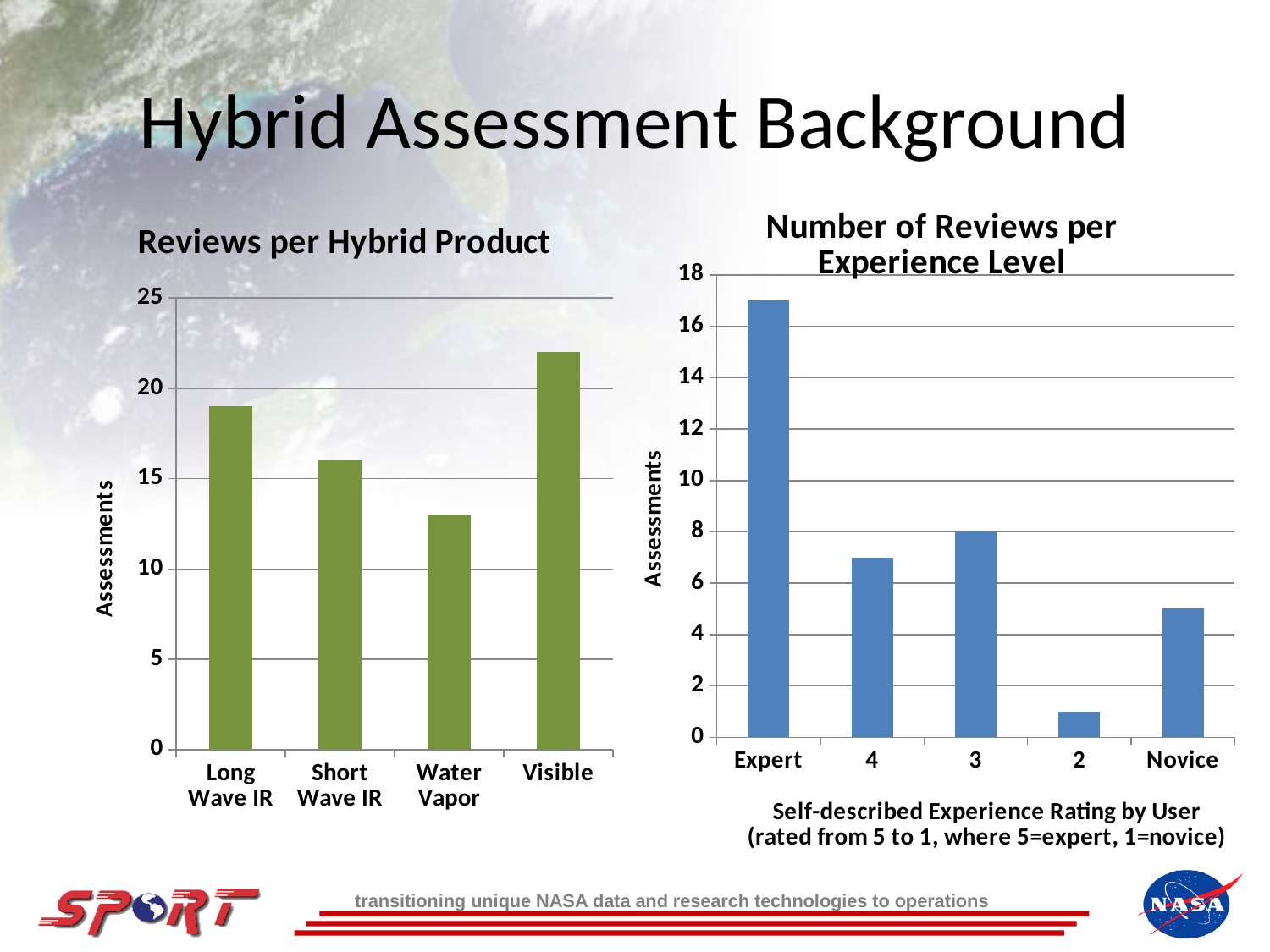
How many product categories are shown on the 'Reviews per Hybrid Product' chart? 4 On the 'Reviews per Hybrid Product' chart, is the value for Water Vapor greater or less than 15? less On the 'Reviews per Hybrid Product' chart, which has more assessments, Long Wave IR or Short Wave IR? Long Wave IR What type of chart is the 'Reviews per Hybrid Product' chart? bar chart On the 'Reviews per Hybrid Product' chart, which product has the lowest number of assessments? Water Vapor On the 'Number of Reviews per Experience Level' chart, is the value for Expert greater or less than 16? greater On the 'Number of Reviews per Experience Level' chart, which experience level has the lowest number of assessments? 2 On the 'Reviews per Hybrid Product' chart, is the value for Visible greater or less than 20? greater What is the x-axis title of the 'Number of Reviews per Experience Level' chart? Self-described Experience Rating by User (rated from 5 to 1, where 5=expert, 1=novice) On the 'Number of Reviews per Experience Level' chart, what is the number of assessments for experience level 3? 8 On the 'Reviews per Hybrid Product' chart, which product has the highest number of assessments? Visible On the 'Number of Reviews per Experience Level' chart, which experience level has the highest number of assessments? Expert